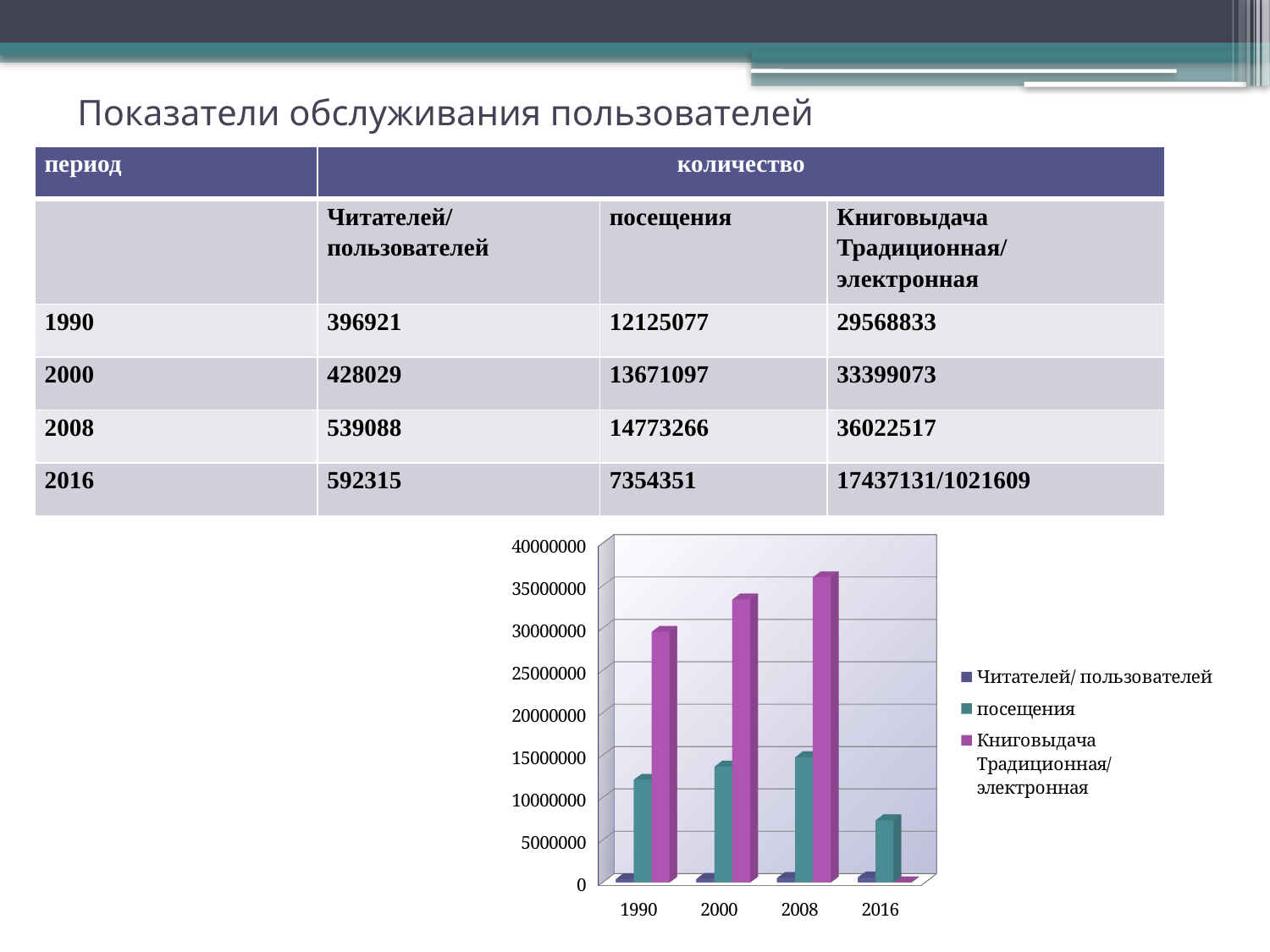
In which year is the посещения bar the lowest? 2016 Is the value for посещения in 2016 greater or less than 10000000? less What kind of chart is shown on the slide? bar chart Is the value for посещения in 1990 greater or less than 10000000? greater In which year is the Книговыдача Традиционная/электронная bar the highest? 2008 Is the value for Книговыдача Традиционная/электронная in 2008 greater or less than 35000000? greater How many series does the chart legend list? 3 Which is larger, посещения in 2008 or посещения in 2000? 2008 What colour are the bars for Книговыдача Традиционная/электронная in the chart? magenta (purple) Do the посещения values rise or fall from 1990 to 2008? rise How many periods (years) are shown on the x axis of the chart? 4 According to the table on the slide, what is the number of Читателей/пользователей in 2016? 592315